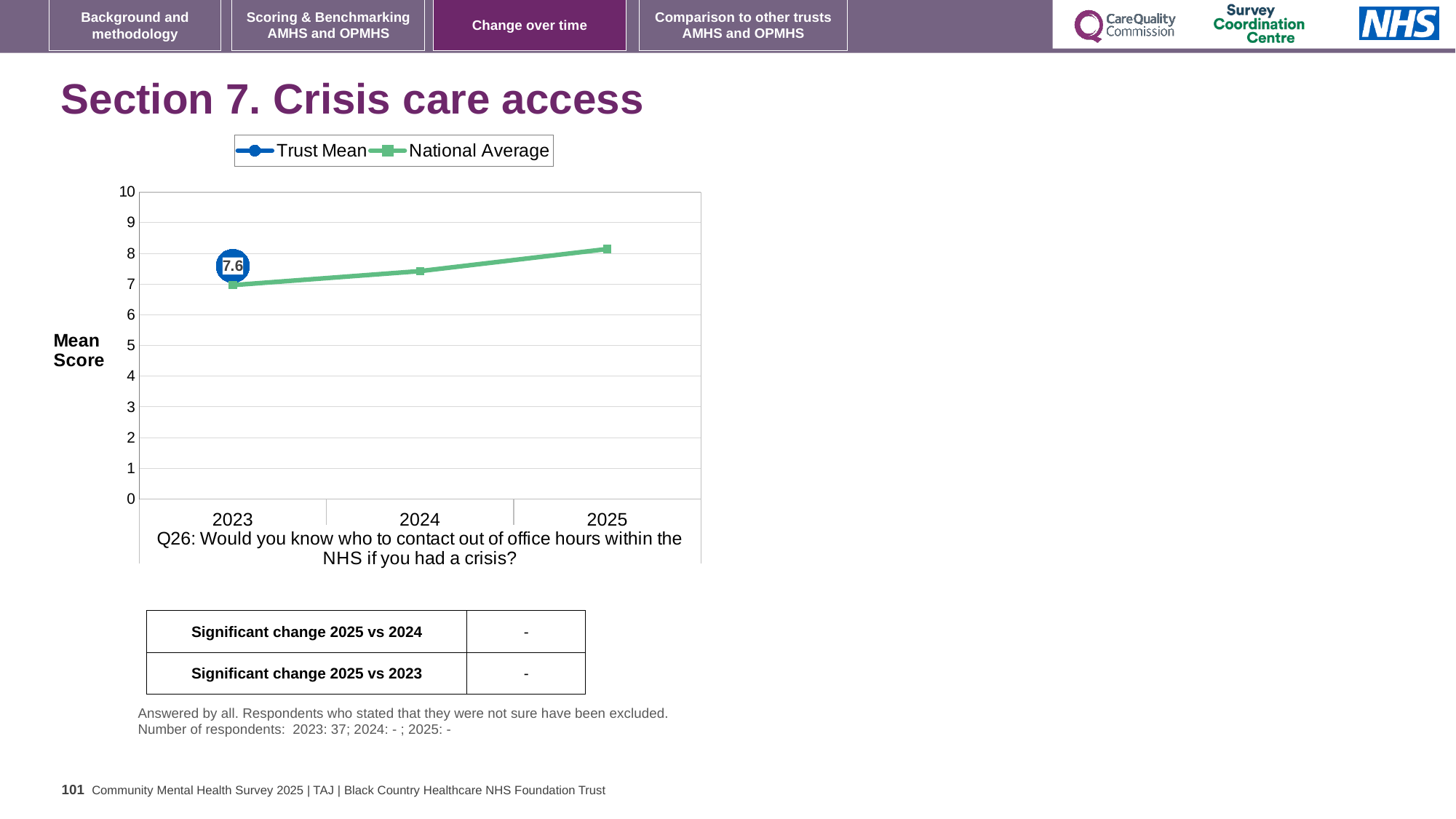
Is the National Average value for 2025 greater or less than 9? less Is the National Average value for 2024 greater or less than 7? greater How many years are shown on the x axis? 3 What kind of chart is shown on the slide? line chart What are the two series named in the legend? Trust Mean and National Average Which year has the highest National Average value? 2025 Which year has the lowest National Average value? 2023 Is the National Average value for 2024 greater or less than 8? less What is the Trust Mean value for 2023? 7.6 How many series does the legend list? 2 Does the National Average rise or fall from 2023 to 2025? rise